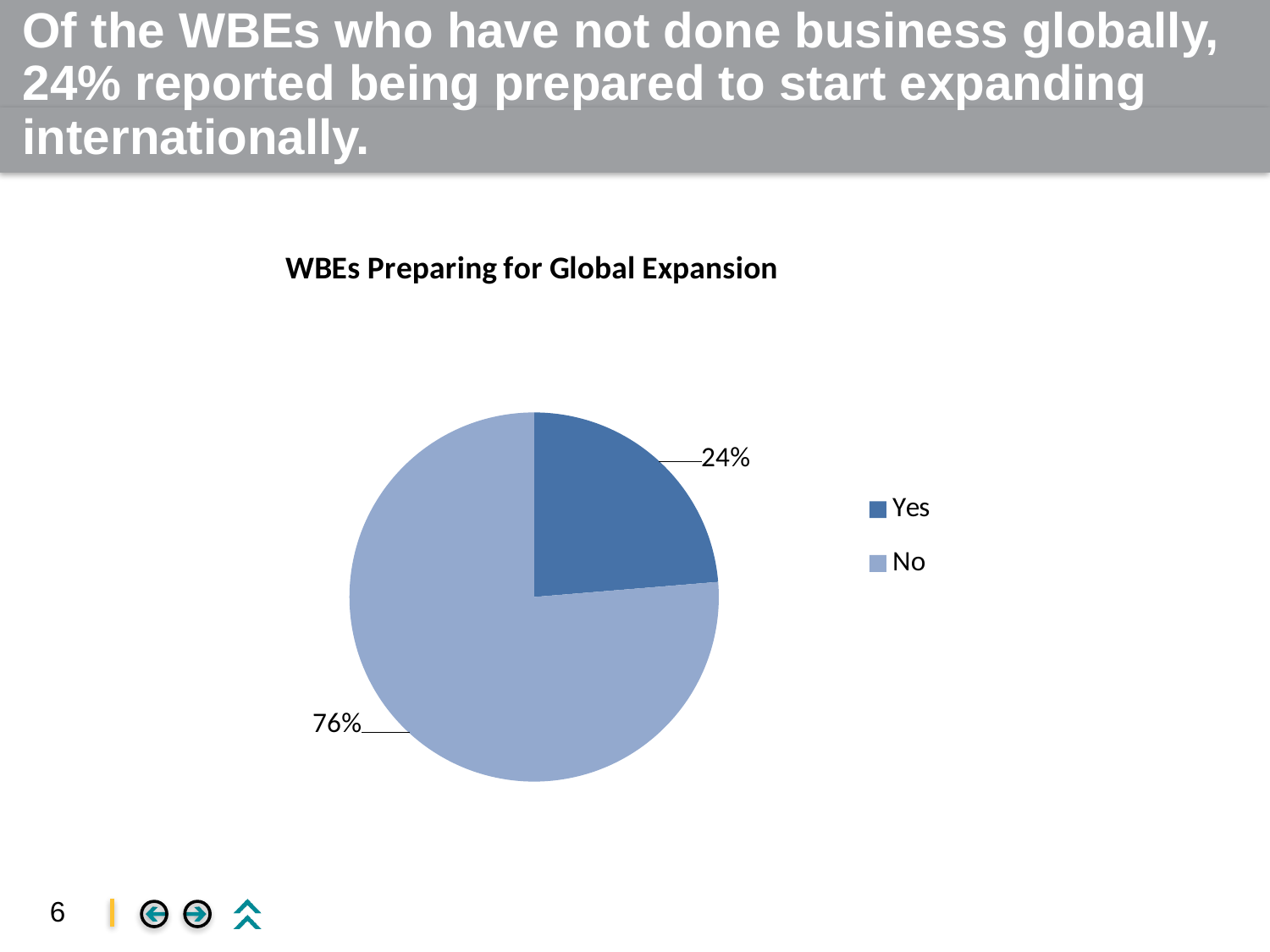
What share of the pie does the "Yes" slice represent? 24% What is the title of the chart? WBEs Preparing for Global Expansion What percentage of the pie is labelled "No"? 76% What percentage of the pie is labelled "Yes"? 24% What is the difference in percentage points between the "No" and "Yes" slices? 52 Which category has the largest share of the pie? No How many entries does the legend list? 2 What type of chart is shown on the slide? pie chart Which category has the smallest share of the pie? Yes Which legend entry is shown in the darker blue colour? Yes Which slice is larger, "Yes" or "No"? No How many slices does the pie chart have? 2